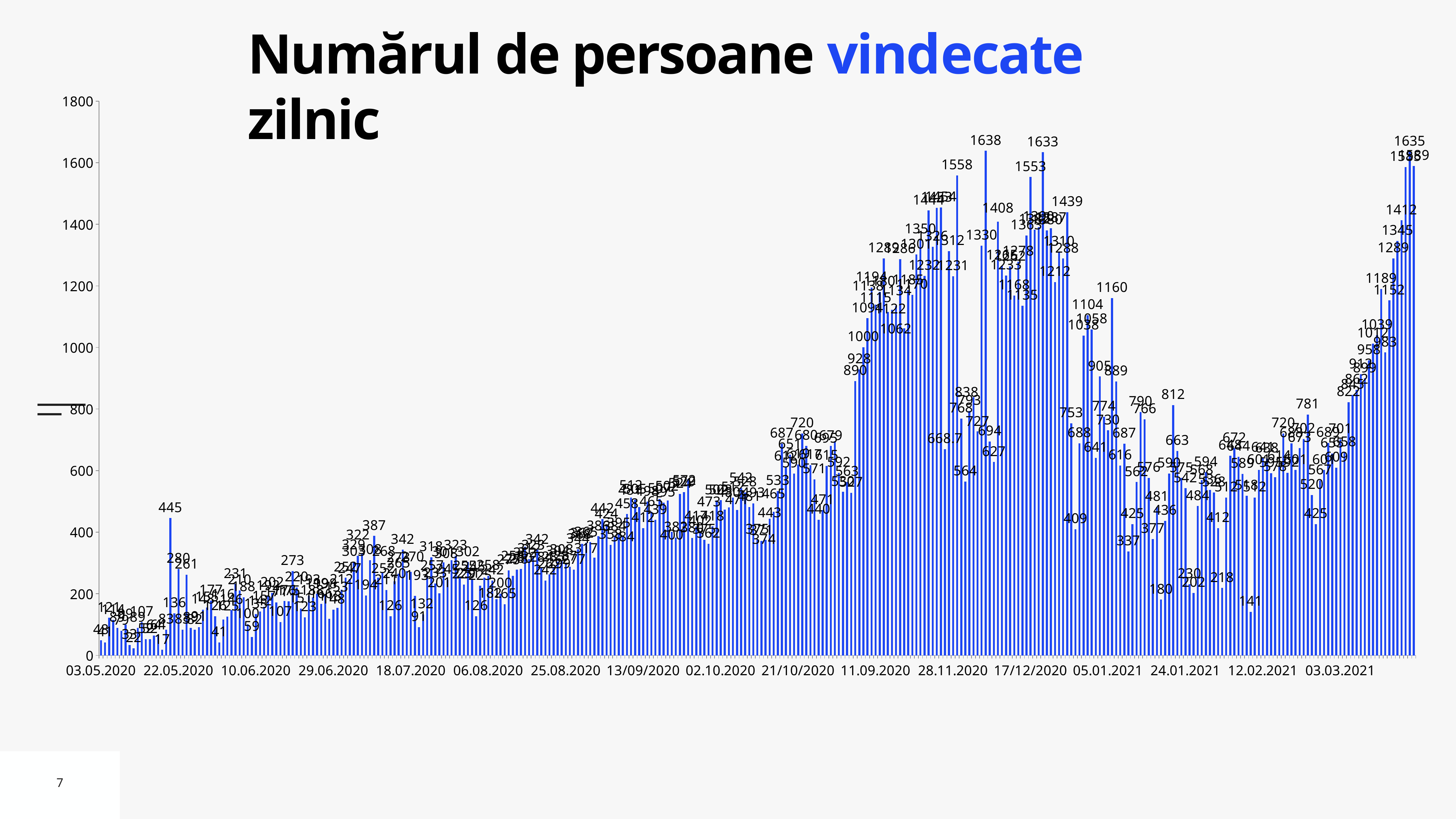
Overall, do the values rise or fall from May 2020 to March 2021? rise What is the lowest value labelled on the chart? 17 What is the title of the chart? Numărul de persoane vindecate zilnic What is the value of the last bar on the right of the chart? 1589 What is the highest value labelled on the chart? 1638 Which is larger, the peak labelled 1638 or the peak labelled 1633? 1638 What is the difference between the two highest labelled values, 1638 and 1633? 5 What is the maximum value shown on the vertical axis? 1800 Is the value of the first bar at 03.05.2020 greater or less than 200? less How many date labels are shown on the horizontal axis? 17 What is the value of the tallest bar in May 2020 (the spike near 22.05.2020)? 445 What kind of chart is shown on the slide? bar chart